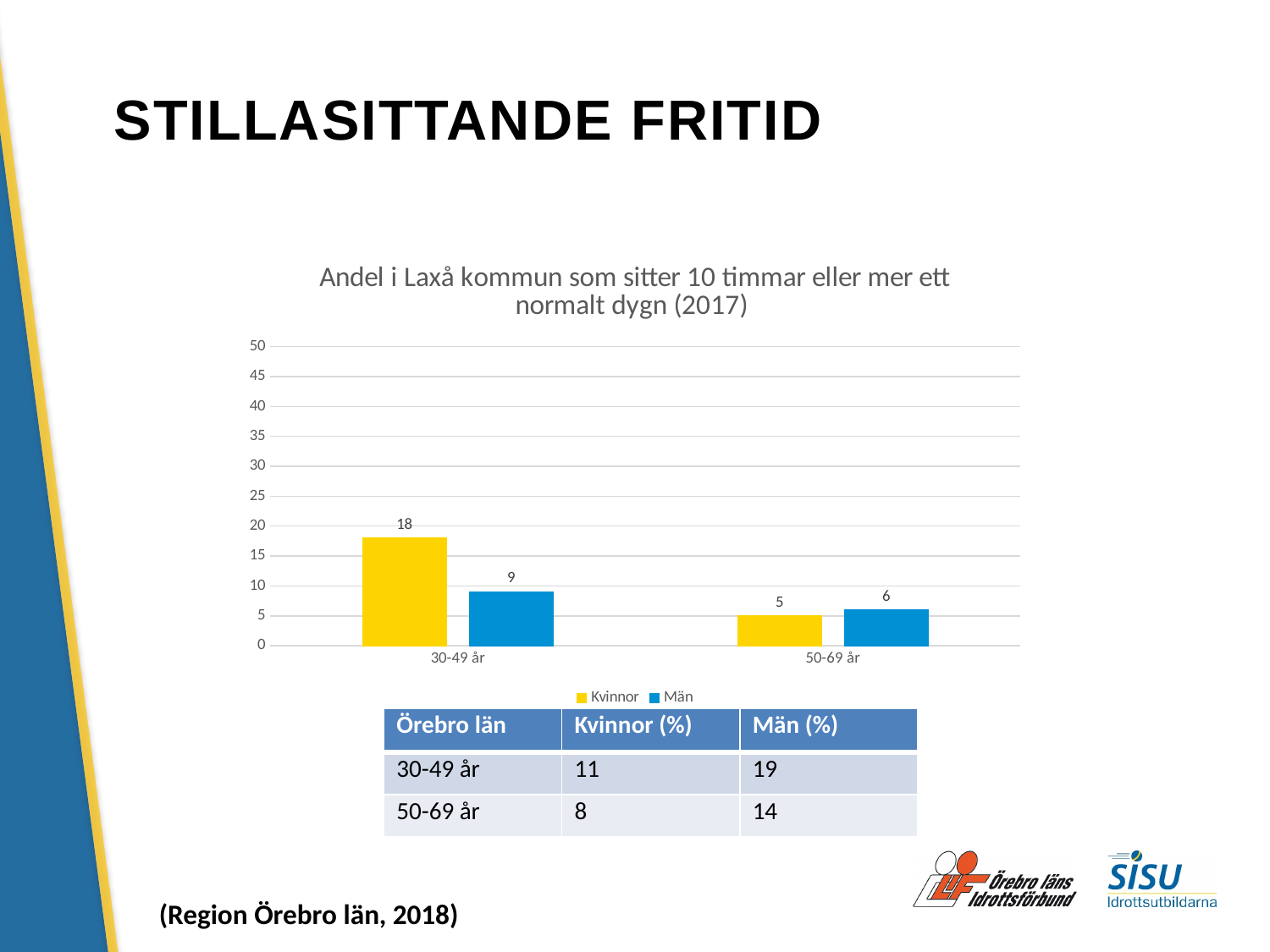
What is the difference between the Kvinnor and Män values in the 30-49 år category? 9 What is the value for Kvinnor in the 30-49 år category? 18 In the 50-69 år category, which series has the larger value, Kvinnor or Män? Män How many categories are shown on the x axis? 2 Is the value for Kvinnor in the 30-49 år category greater or less than 15? greater Which category has the lowest value for Män? 50-69 år What kind of chart is shown on the slide? bar chart Which category has the highest value for Kvinnor? 30-49 år What is the value for Män in the 50-69 år category? 6 How many series does the legend list? 2 What is the value for Män in the 30-49 år category? 9 What is the title of the chart? Andel i Laxå kommun som sitter 10 timmar eller mer ett normalt dygn (2017)